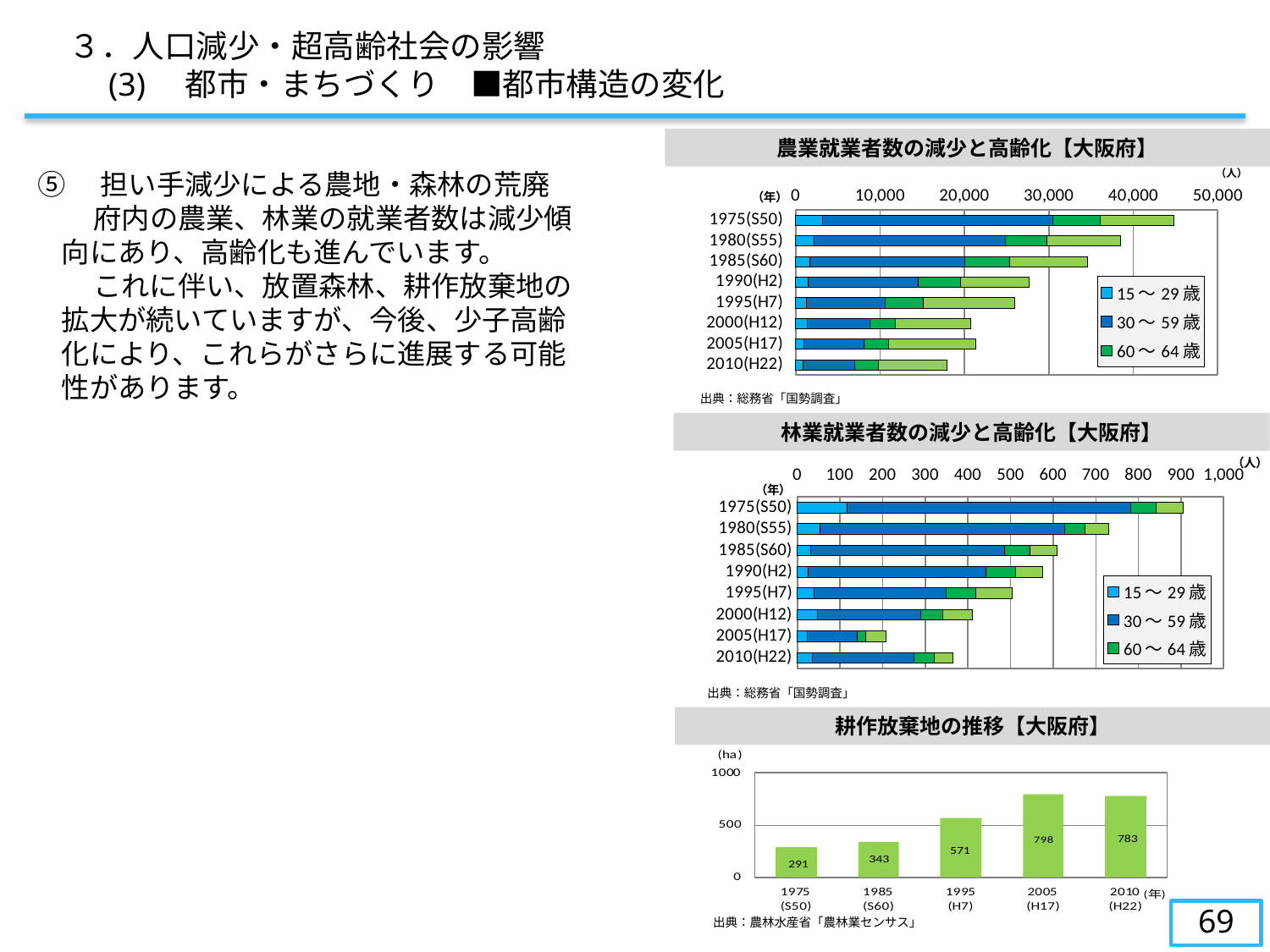
In the 耕作放棄地の推移【大阪府】 chart, which is larger, the value for 1985(S60) or 1995(H7)? 1995(H7) How many series does the legend of the 農業就業者数の減少と高齢化【大阪府】 chart list? 3 In the 農業就業者数の減少と高齢化【大阪府】 chart, is the total bar length for 1975(S50) greater or less than 40,000? greater In the 林業就業者数の減少と高齢化【大阪府】 chart, is the total bar length for 2005(H17) greater or less than 300? less What kind of chart is the 耕作放棄地の推移【大阪府】 chart? Bar chart In the 耕作放棄地の推移【大阪府】 chart, what is the difference between the values for 2005(H17) and 1975(S50)? 507 What kind of chart is the 農業就業者数の減少と高齢化【大阪府】 chart? Stacked bar chart How many years are plotted in the 耕作放棄地の推移【大阪府】 chart? 5 In the 耕作放棄地の推移【大阪府】 chart, which year has the lowest value? 1975(S50) In the 耕作放棄地の推移【大阪府】 chart, what is the value for 1995(H7)? 571 In the 耕作放棄地の推移【大阪府】 chart, which year has the highest value? 2005(H17) In the 農業就業者数の減少と高齢化【大阪府】 chart, do the total bar lengths generally rise or fall from 1975(S50) to 2010(H22)? fall